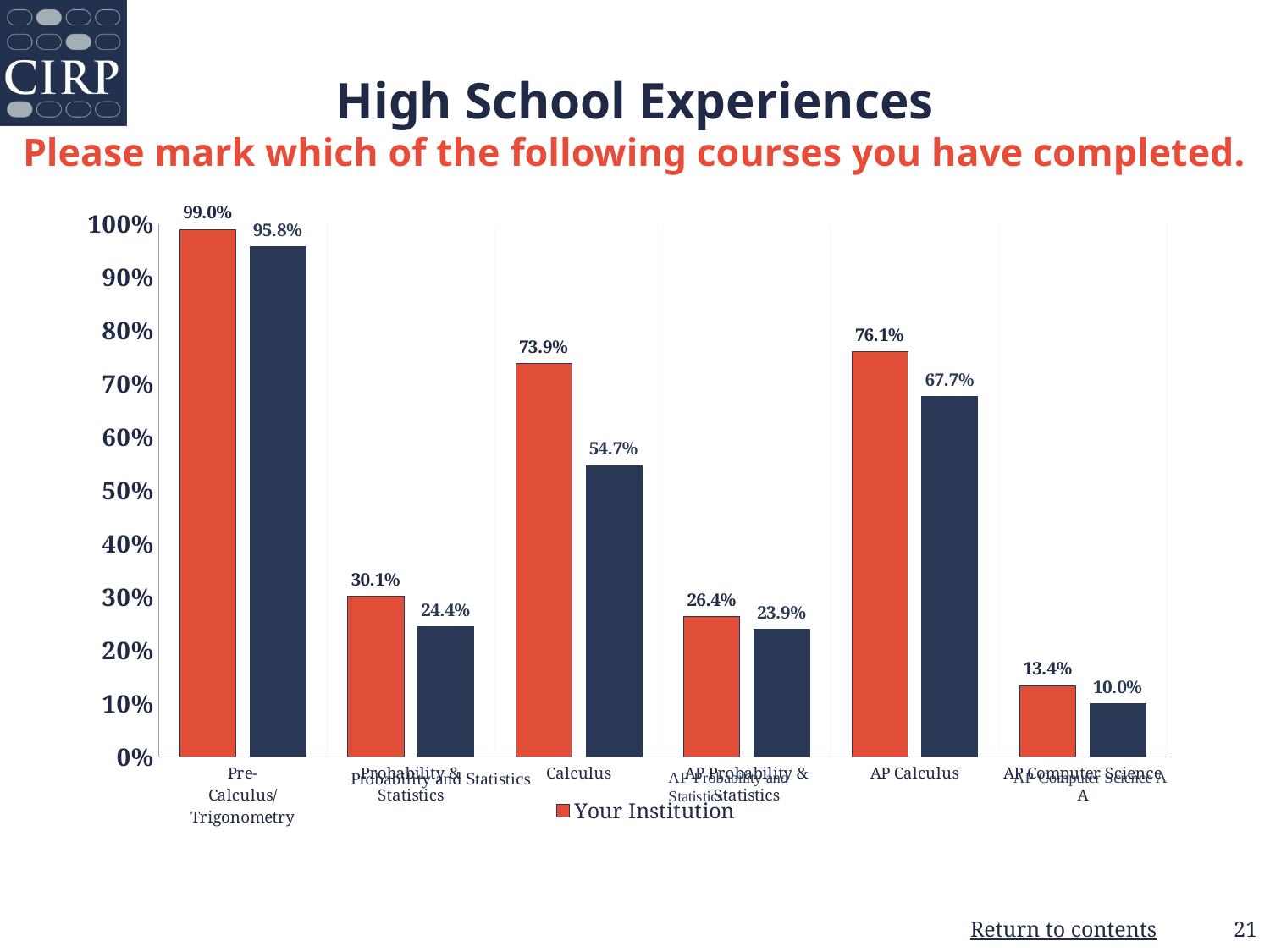
What is the difference between the Your Institution values for AP Calculus and Calculus? 2.2% What is the value for Your Institution for AP Computer Science A? 13.4% What kind of chart is shown on the slide? Bar chart Which is larger for Your Institution: Probability & Statistics or AP Probability & Statistics? Probability & Statistics Which course has the highest value for Your Institution? Pre-Calculus/Trigonometry What is the difference between the Your Institution value and the dark blue bar value for Calculus? 19.2% What is the value for Your Institution for Calculus? 73.9% Which course has the lowest value for Your Institution? AP Computer Science A What is the value shown by the dark blue bar for Pre-Calculus/Trigonometry? 95.8% What is the value for Your Institution for AP Calculus? 76.1% Is the Your Institution value for AP Calculus greater or less than 70%? greater How many course categories are shown on the chart? 6